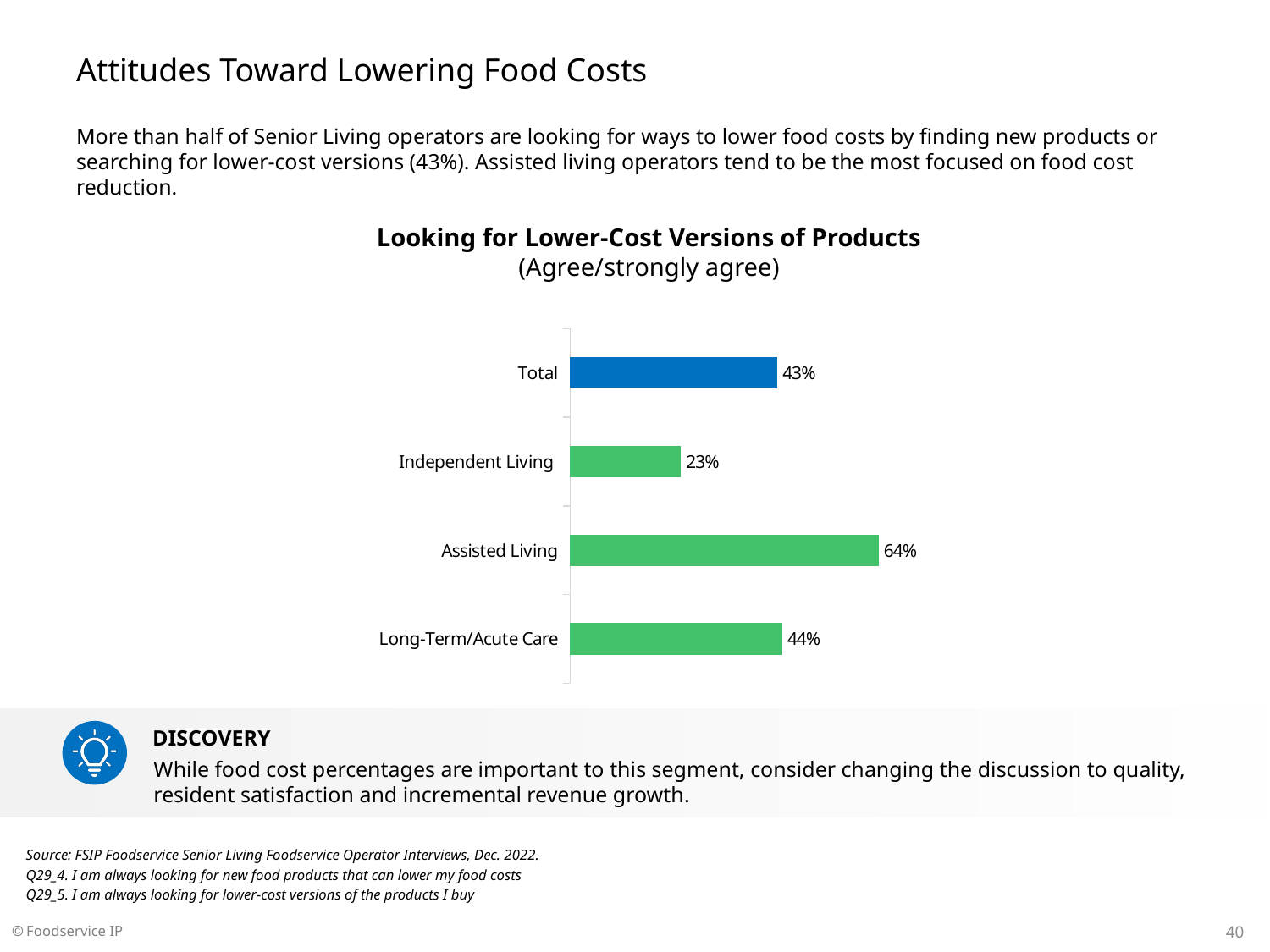
What is the value for Assisted Living? 64% What is the value for Independent Living? 23% Which is larger, the value for Assisted Living or the value for Long-Term/Acute Care? Assisted Living What is the value for Total? 43% How many categories are shown in the chart? 4 What is the difference between the values for Long-Term/Acute Care and Total? 1% Which category has the lowest value? Independent Living What kind of chart is shown on the slide? Bar chart What is the value for Long-Term/Acute Care? 44% What is the title of the chart? Looking for Lower-Cost Versions of Products Which category has the highest value? Assisted Living What is the difference between the values for Assisted Living and Independent Living? 41%